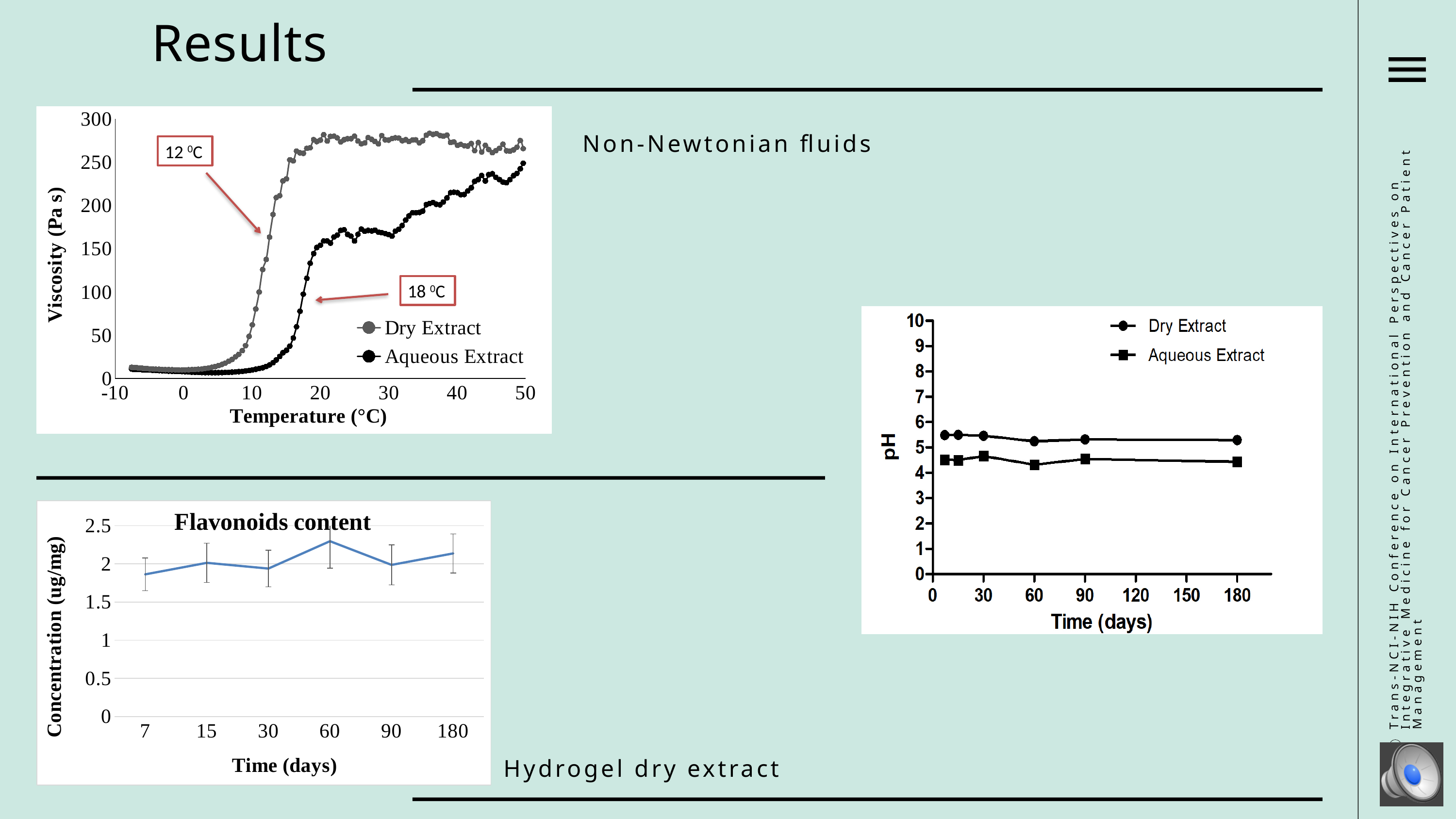
In the pH chart (right), which series has the higher pH at 180 days, Dry Extract or Aqueous Extract? Dry Extract In the viscosity versus temperature chart (top left), how many series does the legend list? 2 In the viscosity versus temperature chart (top left), does viscosity generally rise or fall as temperature increases from 0 to 20 °C? rise In the Flavonoids content chart (bottom left), is the concentration at 7 days greater or less than 2 ug/mg? less In the viscosity versus temperature chart (top left), is the Aqueous Extract viscosity at 30 °C greater or less than 200 Pa s? less In the Flavonoids content chart (bottom left), at which time point is the concentration highest? 60 days In the Flavonoids content chart (bottom left), how many time points are plotted? 6 In the viscosity versus temperature chart (top left), what temperature is annotated for the Dry Extract curve? 12 ºC In the viscosity versus temperature chart (top left), is the Dry Extract viscosity at 30 °C greater or less than 250 Pa s? greater In the viscosity versus temperature chart (top left), what temperature is annotated for the Aqueous Extract curve? 18 ºC In the viscosity versus temperature chart (top left), which series has the higher viscosity at 20 °C, Dry Extract or Aqueous Extract? Dry Extract